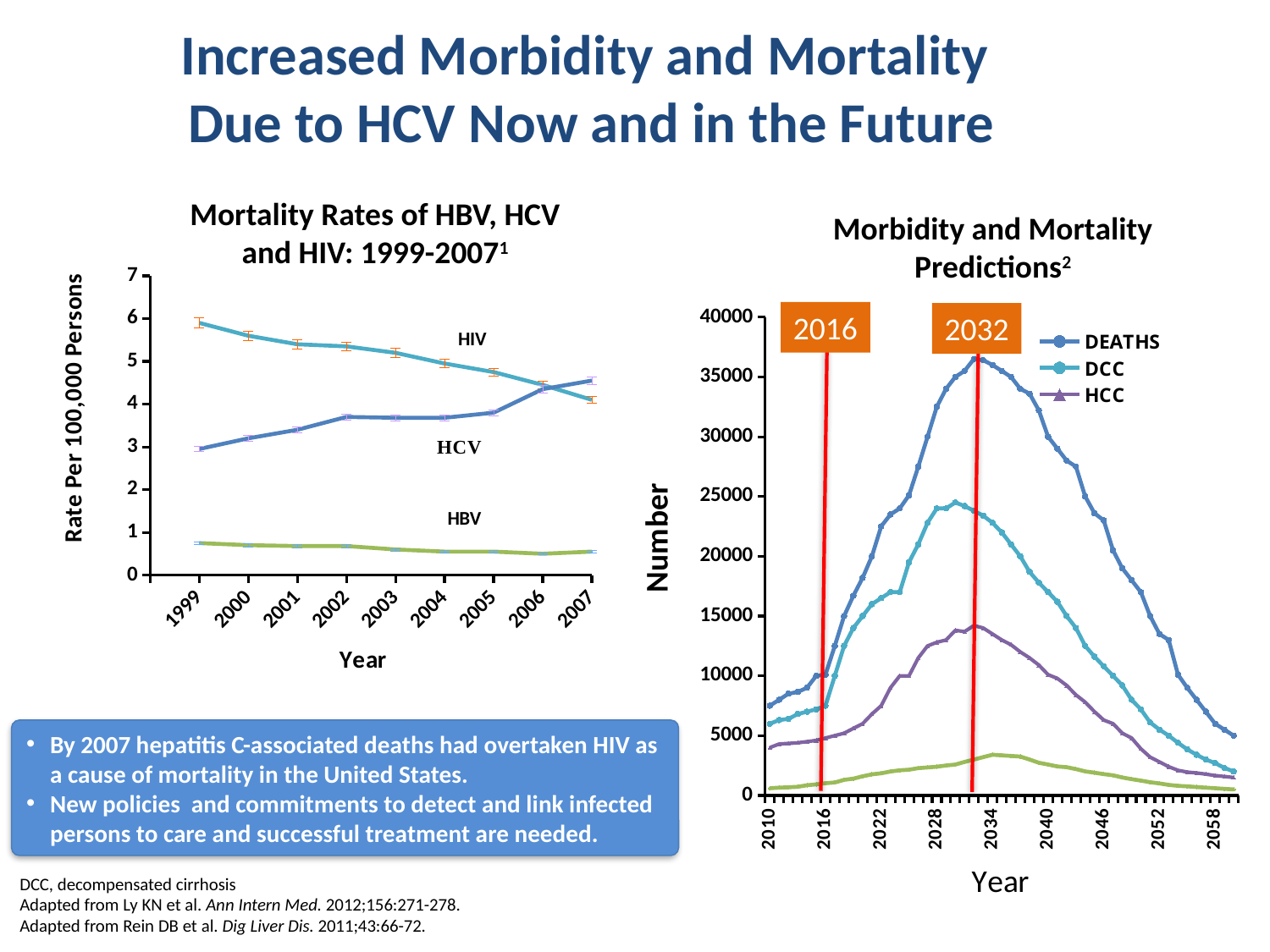
In the left chart 'Mortality Rates of HBV, HCV and HIV: 1999-2007', does the HCV rate rise or fall from 1999 to 2007? rise In the left chart 'Mortality Rates of HBV, HCV and HIV: 1999-2007', which series has the lowest rate across all years? HBV In the right chart 'Morbidity and Mortality Predictions', how many series does the legend list? 3 In the left chart 'Mortality Rates of HBV, HCV and HIV: 1999-2007', is the HIV rate in 1999 greater or less than 5? greater In the left chart 'Mortality Rates of HBV, HCV and HIV: 1999-2007', how many years are shown on the x axis? 9 In the right chart 'Morbidity and Mortality Predictions', which legend series reaches the highest value? DEATHS In the left chart 'Mortality Rates of HBV, HCV and HIV: 1999-2007', which series has the highest rate in 1999? HIV In the left chart 'Mortality Rates of HBV, HCV and HIV: 1999-2007', does the HIV rate rise or fall from 1999 to 2007? fall In the right chart 'Morbidity and Mortality Predictions', which two years are marked by the red vertical lines? 2016 and 2032 In the right chart 'Morbidity and Mortality Predictions', is the peak value of DEATHS greater or less than 35000? greater In the left chart 'Mortality Rates of HBV, HCV and HIV: 1999-2007', is the HCV rate in 2007 greater or less than 4? greater What kind of chart is the 'Mortality Rates of HBV, HCV and HIV: 1999-2007' chart on the left? line chart